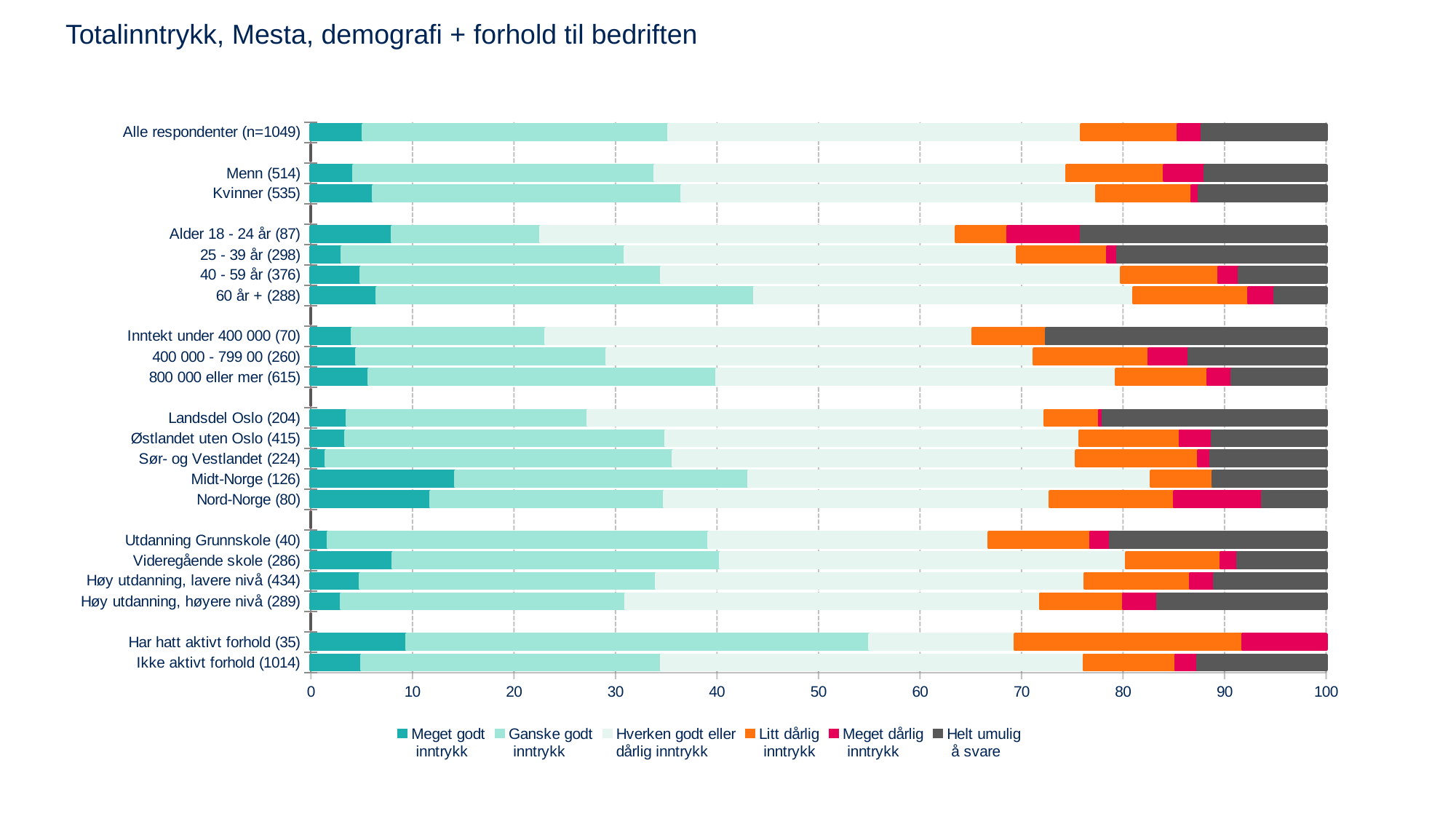
Is the 'Meget godt inntrykk' value for Alder 18 - 24 år (87) greater or less than 10? less Which has the larger 'Ganske godt inntrykk' segment: 60 år + (288) or 25 - 39 år (298)? 60 år + (288) Which category has the smallest 'Helt umulig å svare' segment? Har hatt aktivt forhold (35) Which category has the largest 'Helt umulig å svare' segment? Inntekt under 400 000 (70) Which has the larger 'Meget godt inntrykk' segment: Midt-Norge (126) or Alle respondenter (n=1049)? Midt-Norge (126) What is the title of the chart? Totalinntrykk, Mesta, demografi + forhold til bedriften What kind of chart is shown on the slide? Stacked bar chart Is the 'Meget godt inntrykk' value for Midt-Norge (126) greater or less than 10? greater How many categories (bars) are plotted on the chart? 21 Which legend entry is shown in dark grey? Helt umulig å svare How many series does the legend list? 6 Which category has the largest 'Meget godt inntrykk' segment? Midt-Norge (126)